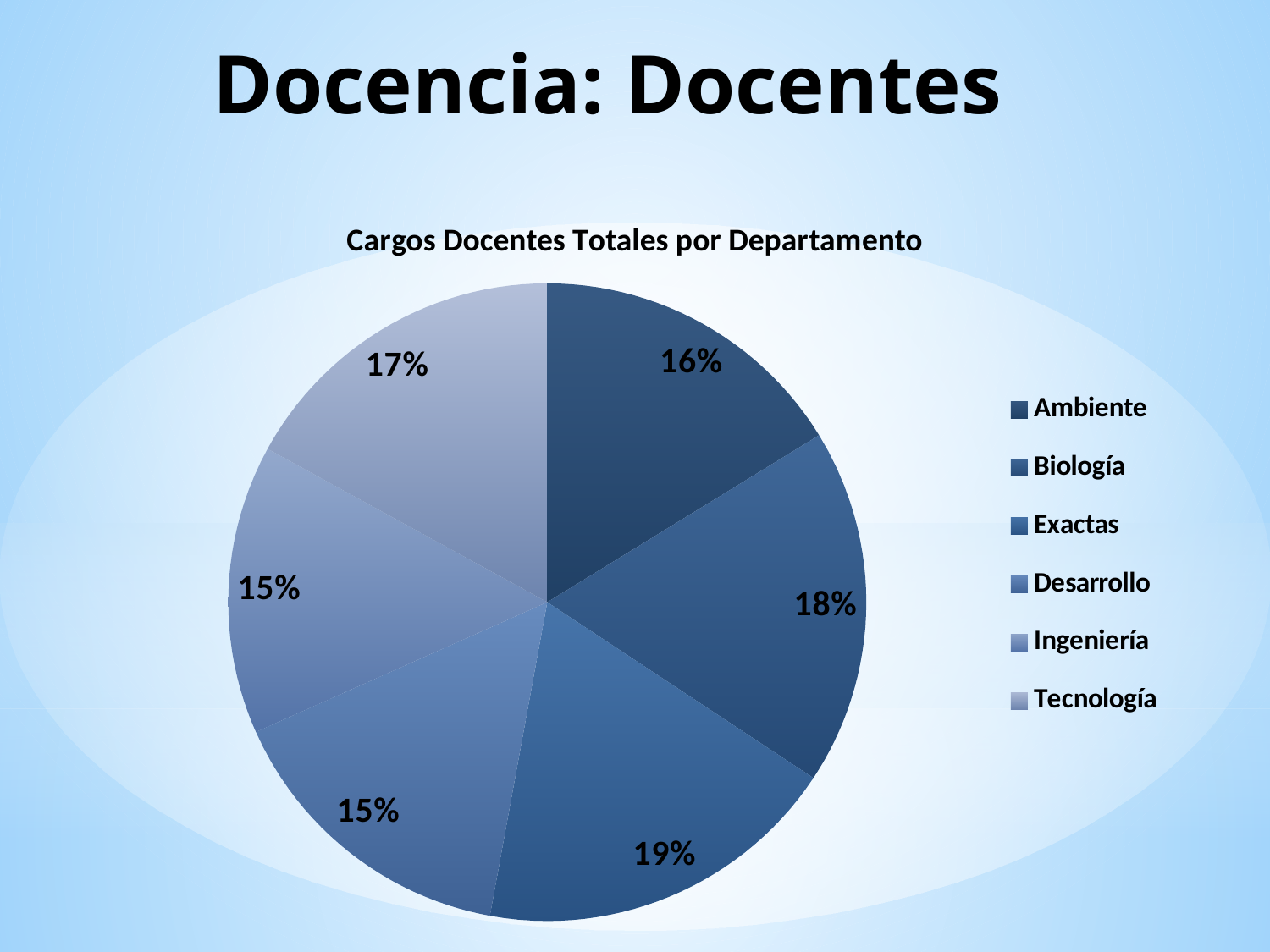
What share of the pie does Tecnología have? 17% What share of the pie does Ambiente have? 16% Which department has the largest share of the pie? Exactas Which is larger, the share for Biología or the share for Ambiente? Biología What share of the pie does Biología have? 18% What is the difference between the share for Exactas and the share for Ingeniería? 4% What kind of chart is shown on the slide? pie chart How many departments does the legend list? 6 Which two departments share the same percentage of 15%? Desarrollo and Ingeniería What is the title of the chart? Cargos Docentes Totales por Departamento